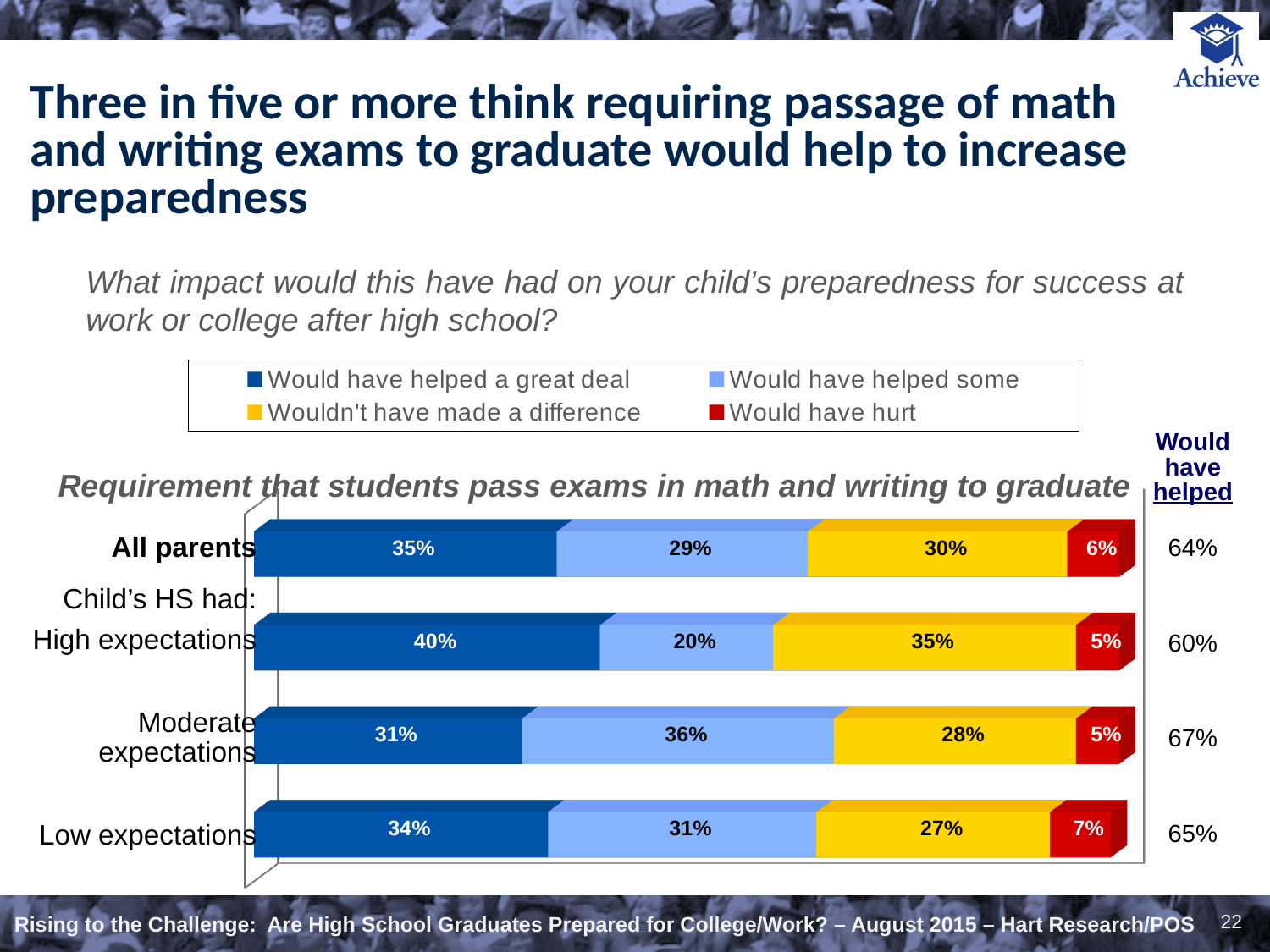
Which category has the lowest share saying the requirement wouldn't have made a difference? Low expectations What kind of chart is shown on the slide? Stacked bar chart Which is larger: the 'Wouldn't have made a difference' value for High expectations or for All parents? High expectations Which category has the highest share saying the requirement would have helped a great deal? High expectations What percentage of parents whose child's high school had moderate expectations said the requirement would have helped some? 36% What is the combined 'Would have helped' total shown for Moderate expectations? 67% Which series is shown in red in the chart? Would have hurt What percentage of all parents said the requirement would have helped a great deal? 35% What is the difference between the 'Would have helped some' values for High expectations and Moderate expectations? 16 percentage points How many series does the legend list? 4 What percentage of parents whose child's high school had low expectations said the requirement would have hurt? 7% How many categories (bars) are shown in the chart? 4